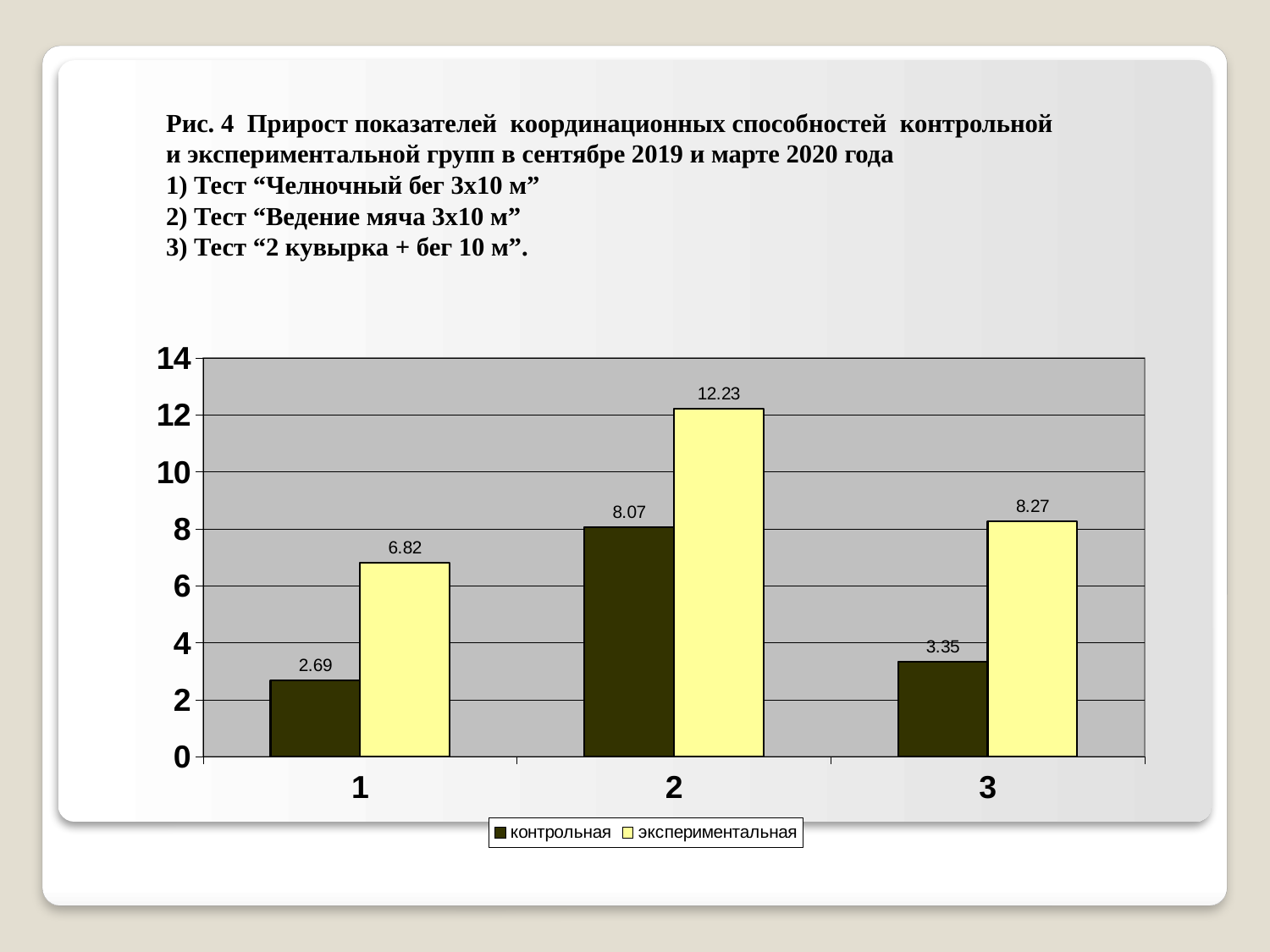
What is the value for the экспериментальная series at category 1? 6.82 Is the value for the контрольная series at category 2 greater or less than 6? greater How many categories are shown on the x axis? 3 What is the difference between the экспериментальная and контрольная values at category 2? 4.16 Which category has the lowest value for the контрольная series? 1 What kind of chart is shown on the slide? bar chart How many series does the legend list? 2 What is the value for the контрольная series at category 1? 2.69 What is the value for the контрольная series at category 3? 3.35 What is the value for the экспериментальная series at category 2? 12.23 Which is larger at category 3: the контрольная value or the экспериментальная value? экспериментальная Which category has the highest value for the экспериментальная series? 2